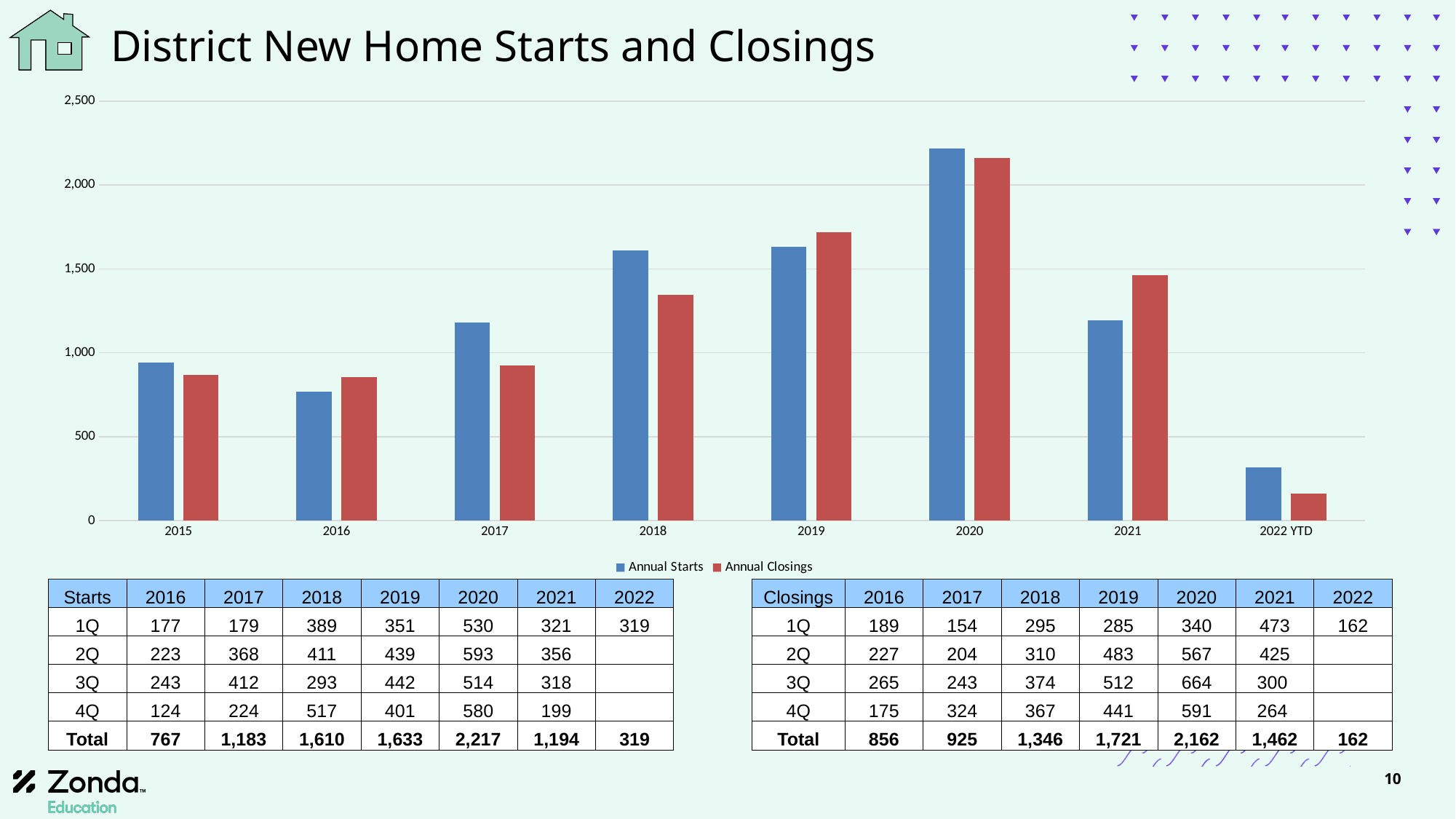
What is the difference between Annual Starts and Annual Closings in 2020? 55 How many year categories are shown on the x axis of the chart? 8 What are the two entries in the chart legend? Annual Starts and Annual Closings Do Annual Starts rise or fall from 2016 to 2020? rise In 2019, which is larger: Annual Starts or Annual Closings? Annual Closings Which year has the highest Annual Starts? 2020 Which year has the lowest Annual Closings? 2022 YTD Is the Annual Closings value for 2015 greater or less than 1,000? less How many series does the chart legend list? 2 What is the total Annual Closings value for 2019? 1,721 What is the total Annual Starts value for 2018? 1,610 What kind of chart is shown on the slide? bar chart